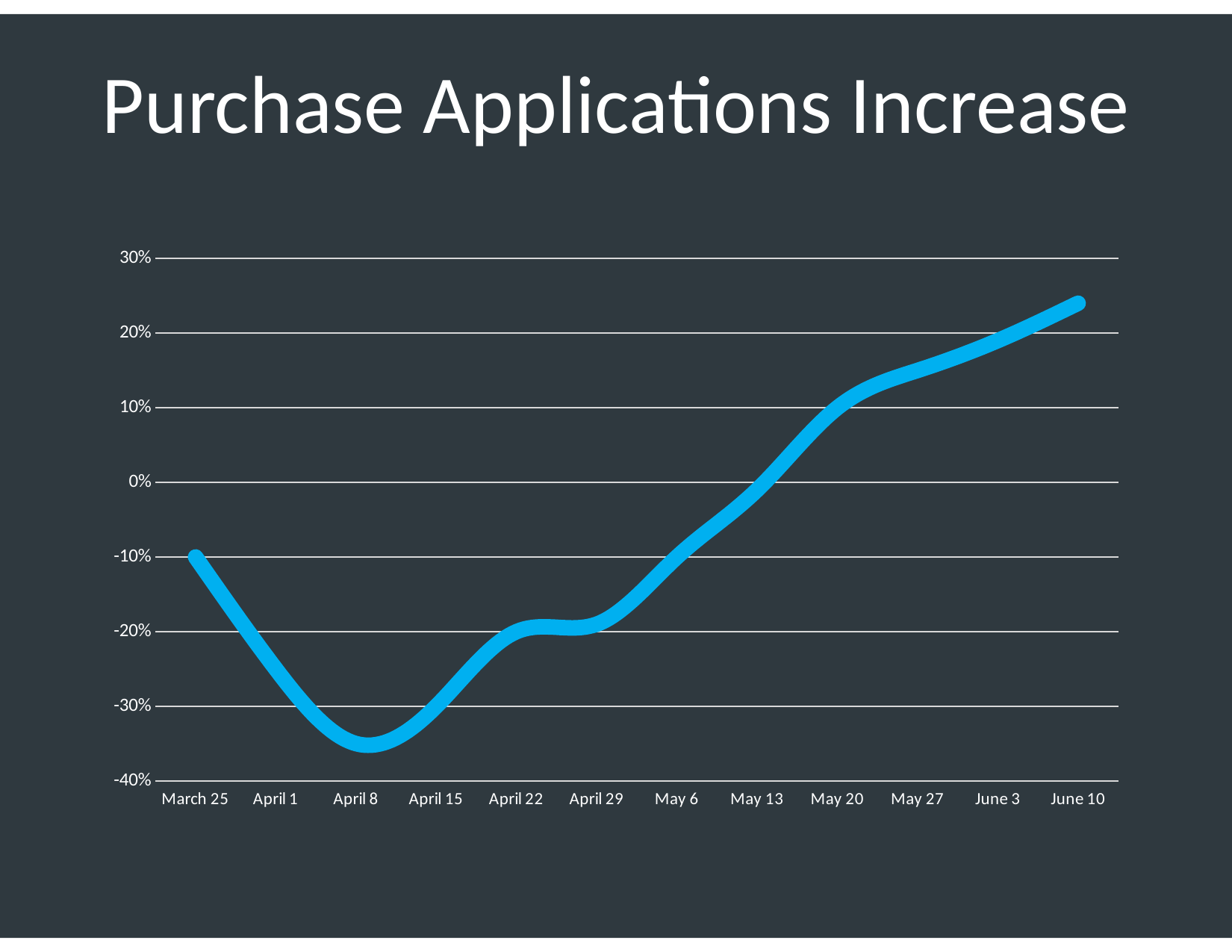
How many dates are shown on the x axis? 12 Is the value for May 27 greater or less than 10%? greater Which is larger, the value for April 8 or the value for April 22? April 22 Is the value for June 10 greater or less than 20%? greater Is the value for May 6 greater or less than 0%? less Does the line rise or fall between April 8 and June 10? rise What is the title of the chart? Purchase Applications Increase What kind of chart is shown on the slide? line chart On which date is the value highest? June 10 On which date is the value lowest? April 8